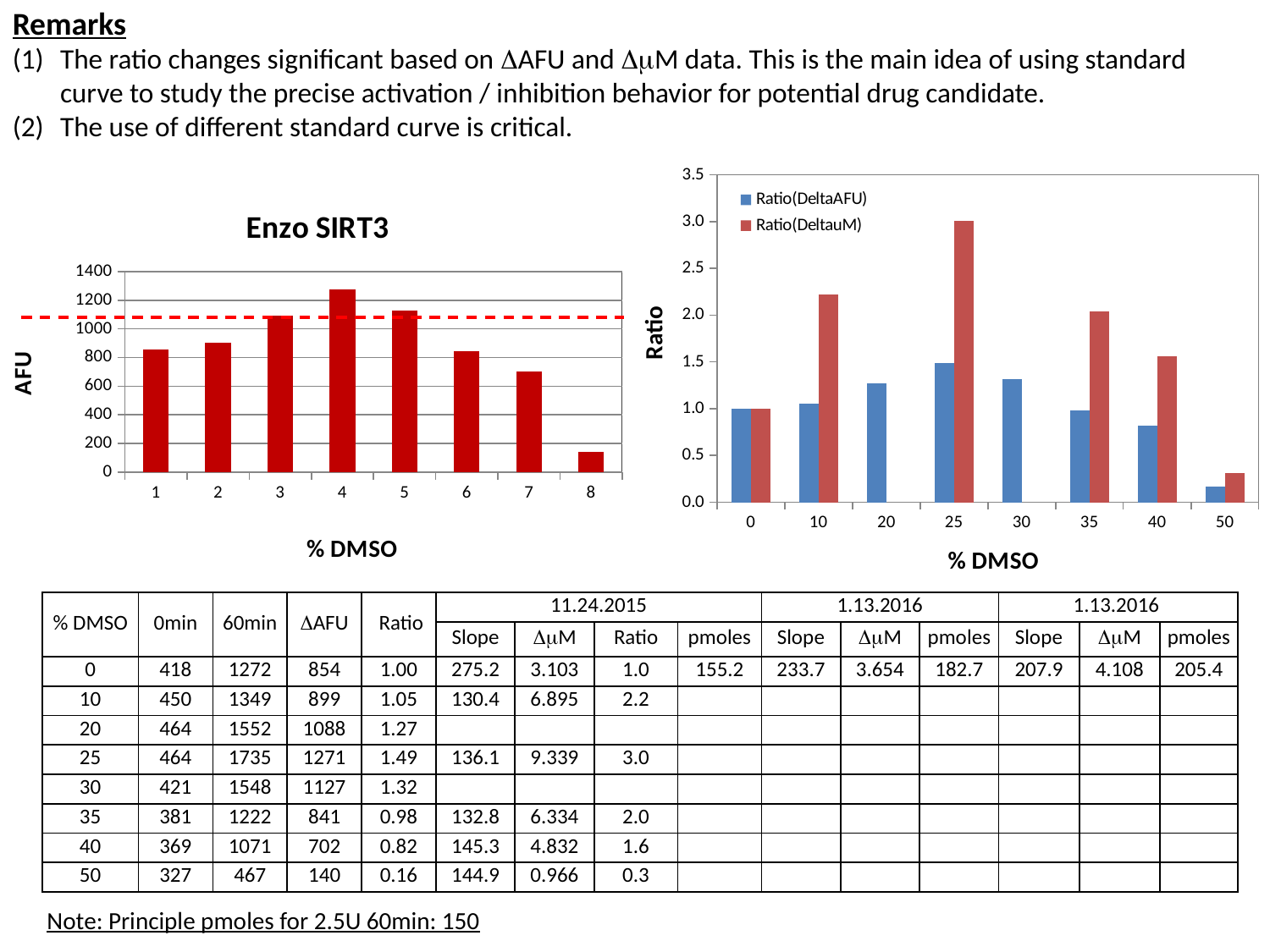
In the Enzo SIRT3 chart, which category has the lowest AFU value? 8 In the Ratio chart on the right, is the Ratio(DeltaAFU) value at 50% DMSO greater or less than 0.5? less In the Enzo SIRT3 chart, which category has the highest AFU value? 4 What kind of chart is the Enzo SIRT3 chart on the left? bar chart In the Enzo SIRT3 chart, which is larger, the AFU value for category 2 or for category 7? category 2 In the Enzo SIRT3 chart, how many bars are plotted? 8 In the Enzo SIRT3 chart, is the AFU value for category 1 greater or less than 1000? less In the Ratio chart on the right, how many series does the legend list? 2 In the Ratio chart on the right, what is the Ratio(DeltauM) value at 25% DMSO? 3.0 In the Ratio chart on the right, at which % DMSO is Ratio(DeltauM) highest? 25 What is the title of the left chart? Enzo SIRT3 In the Ratio chart on the right, what are the two legend entries? Ratio(DeltaAFU) and Ratio(DeltauM)